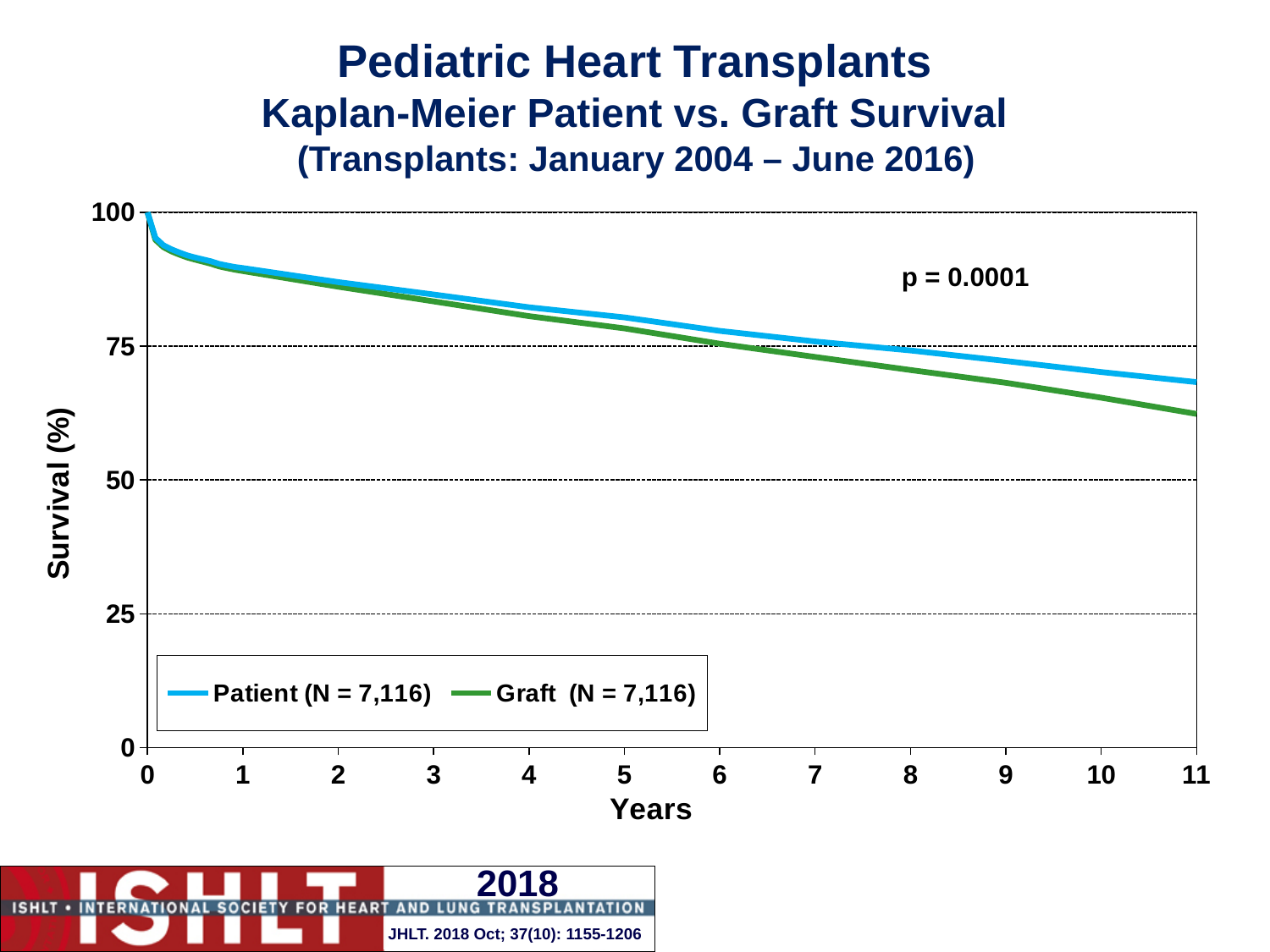
Is the Graft survival value at 11 years greater or less than 75? less What p-value is shown on the chart? p = 0.0001 How many series does the legend list? 2 What kind of chart is shown on the slide? line chart Is the Graft survival value at 2 years greater or less than 75? greater What is the N given for the Graft series in the legend? 7,116 Is the Graft survival value at 9 years greater or less than 75? less Do the survival curves rise or fall as years increase? fall At 10 years, which series has the higher survival, Patient or Graft? Patient